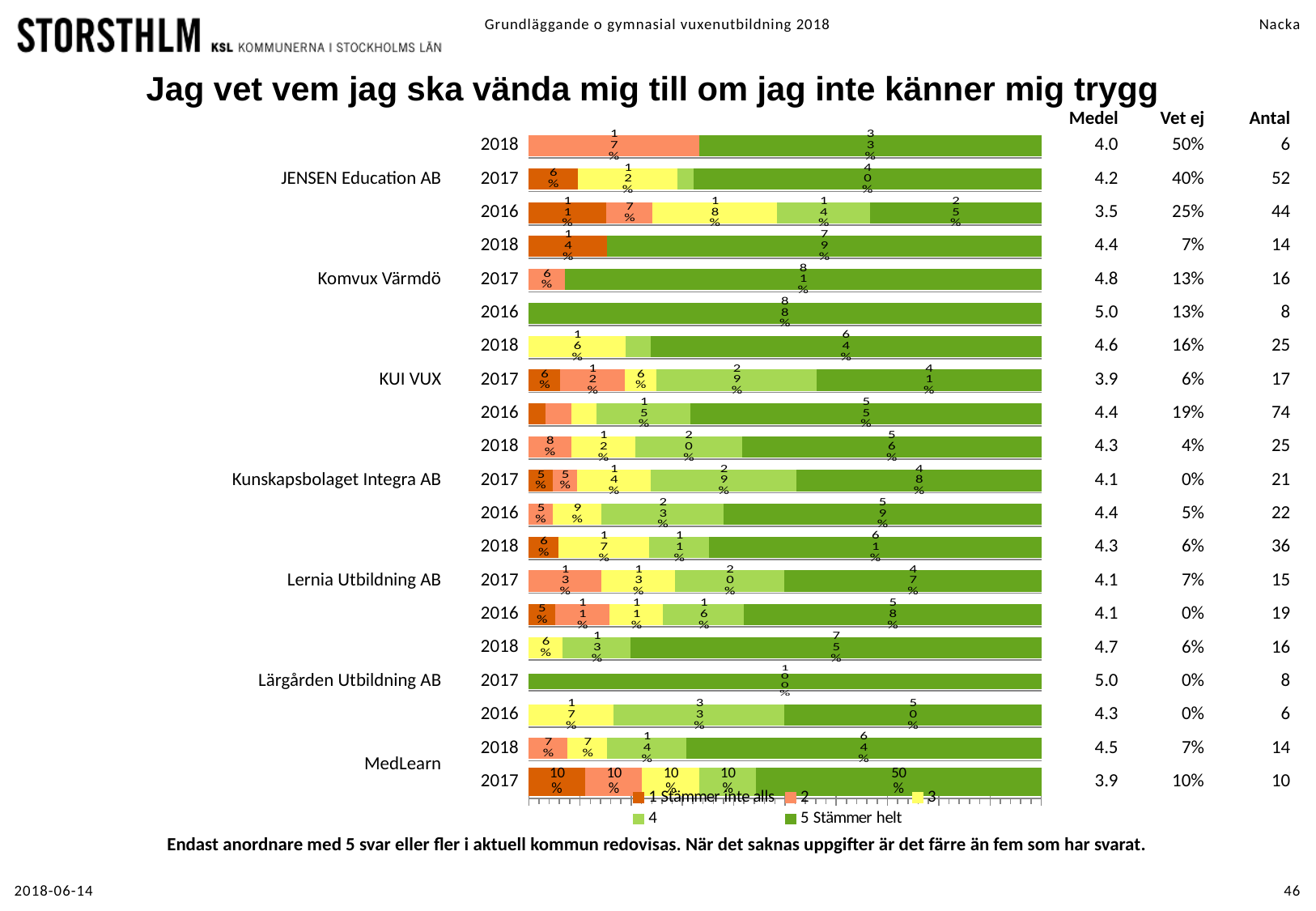
What is the share of '5 Stämmer helt' for MedLearn in 2017? 50% How many series does the chart legend list? 5 What is the difference in percentage points between the '5 Stämmer helt' share for Lärgården Utbildning AB in 2018 (75%) and in 2016 (50%)? 25 percentage points What kind of chart is shown on the slide? Stacked bar chart For Komvux Värmdö, which year has the highest share of '5 Stämmer helt'? 2016 What is the share of '1 Stämmer inte alls' for Komvux Värmdö in 2018? 14% What is the share of '5 Stämmer helt' for Komvux Värmdö in 2016? 88% What is the share of '5 Stämmer helt' for Lärgården Utbildning AB in 2017? 100% Which legend entry is shown in the darkest green colour? 5 Stämmer helt How many education providers (anordnare) are shown in the chart? 7 Which is larger: the '5 Stämmer helt' share for KUI VUX in 2018 or for KUI VUX in 2017? 2018 What is the share of '5 Stämmer helt' for Lernia Utbildning AB in 2018? 61%